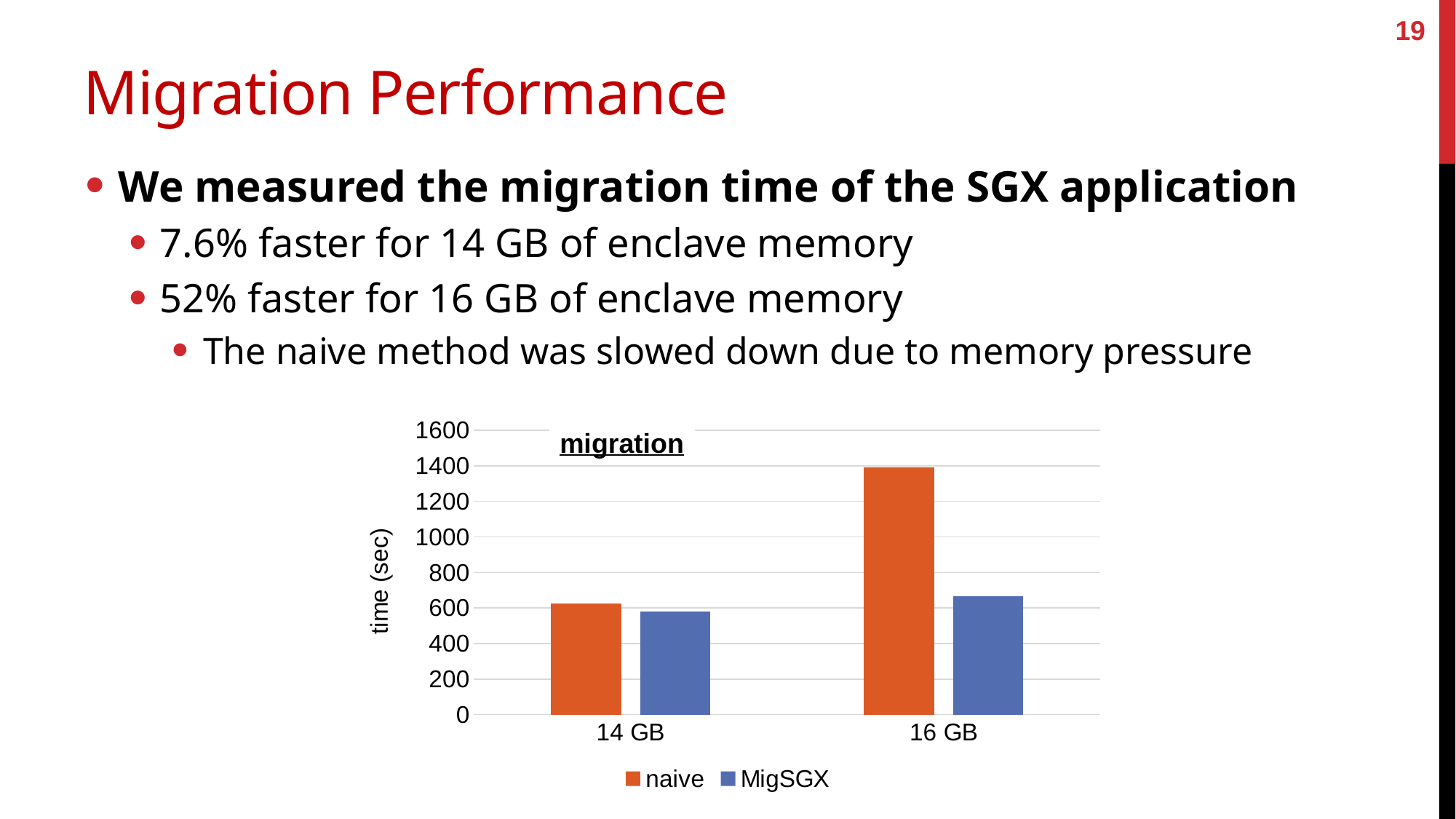
What are the two series named in the chart legend? naive and MigSGX Is the value for naive at 16 GB greater or less than 1200? greater Which bar in the chart is the tallest? naive at 16 GB How many series does the chart legend list? 2 At 16 GB, which series has the larger migration time, naive or MigSGX? naive Is the value for naive at 14 GB greater or less than 800? less Is the value for MigSGX at 16 GB greater or less than 800? less How many memory-size categories are shown on the x axis of the chart? 2 At 14 GB, which series has the larger migration time, naive or MigSGX? naive Which bar in the chart is the shortest? MigSGX at 14 GB What kind of chart is shown on the slide? bar chart What is the title of the chart? migration